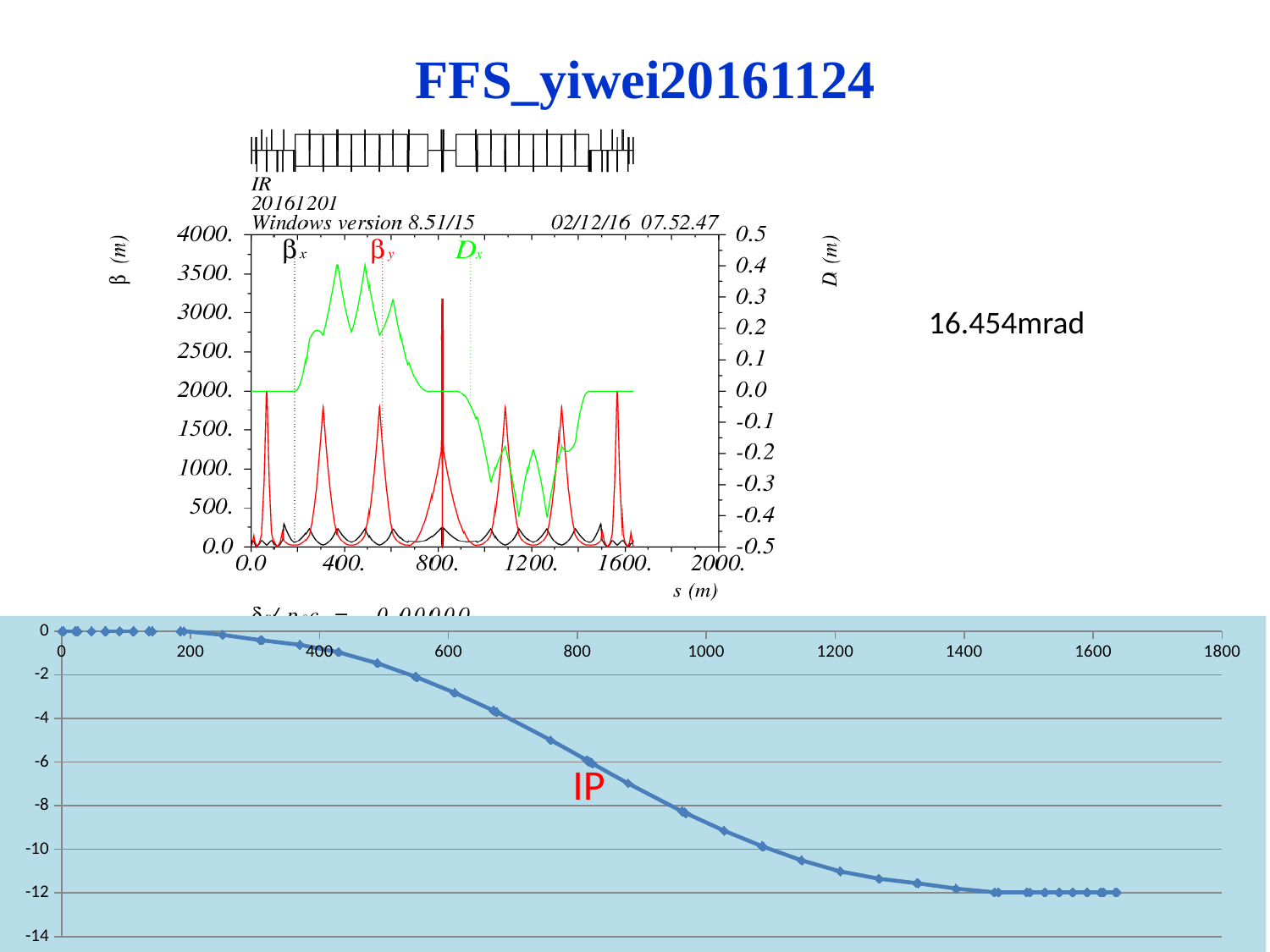
In the top chart, is the maximum of the D_x curve greater or less than 0.3? greater In the top chart, what is the label of the x axis? s (m) In the bottom chart, do the values rise or fall as the x axis increases from 0 to 1800? fall In the bottom chart, is the value at x = 800 greater or less than -4? less In the top chart, which curve is larger at its peak near s = 800: β_x or β_y? β_y In the top chart, is the highest peak of the β_y curve greater or less than 3000? greater In the top chart, which curve reaches the highest peak value on the left β axis? β_y In the bottom chart, what text label is placed next to the curve near x = 800? IP What kind of chart is the bottom chart on the slide? line chart In the top chart, how many curves are plotted? 3